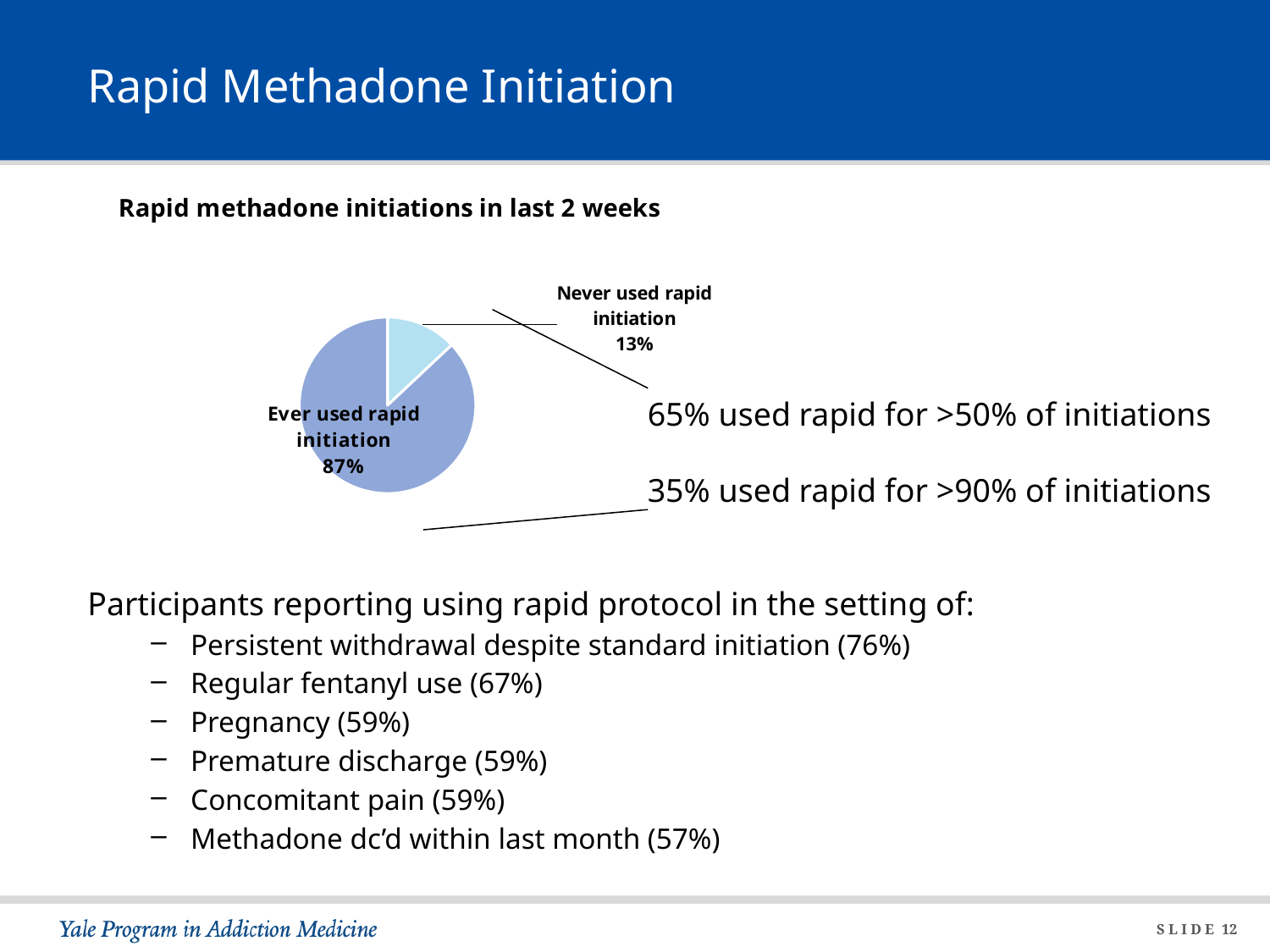
Which labelled slice of the pie chart is the largest? Ever used rapid initiation What is the difference in percentage points between the 'Ever used rapid initiation' and 'Never used rapid initiation' slices? 74 What is the title of the chart on the slide? Rapid methadone initiations in last 2 weeks What percentage of the pie is labelled 'Ever used rapid initiation'? 87% How many labelled slices does the pie chart have? 2 According to the annotation next to the pie chart, what percentage used rapid for >50% of initiations? 65% Which labelled slice of the pie chart is the smallest? Never used rapid initiation What type of chart is shown on the slide? pie chart What share of the pie does the 'Never used rapid initiation' slice represent? 13% Which is larger: the 'Ever used rapid initiation' slice or the 'Never used rapid initiation' slice? Ever used rapid initiation What percentage of the pie is labelled 'Never used rapid initiation'? 13% According to the annotation next to the pie chart, what percentage used rapid for >90% of initiations? 35%